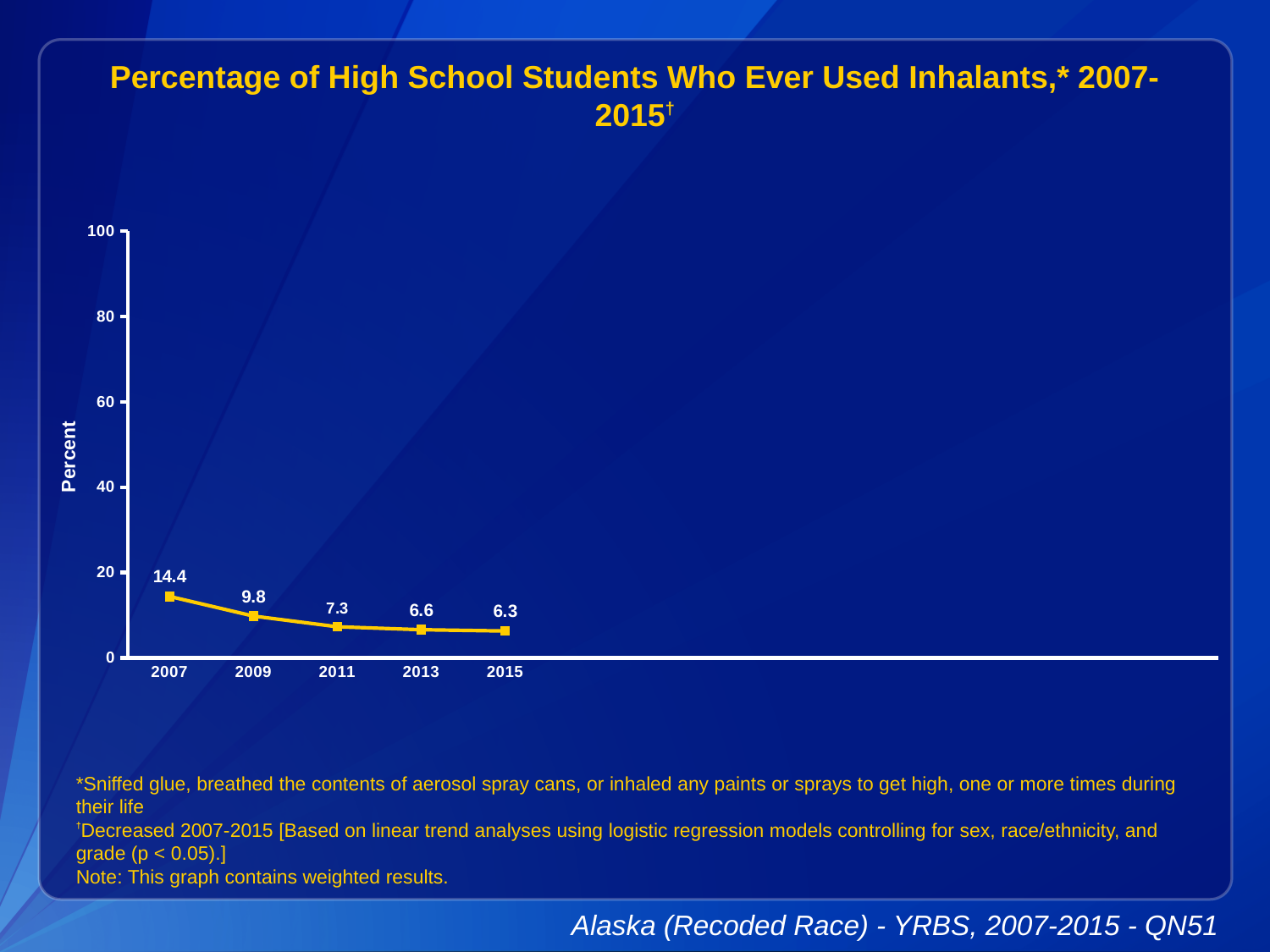
What kind of chart is shown on the slide? line chart What was the percentage of high school students who ever used inhalants in 2011? 7.3 What is the difference between the 2009 and 2011 values? 2.5 Is the value for 2007 greater or less than 20? less Which year had the lowest percentage of students who ever used inhalants? 2015 What was the percentage of high school students who ever used inhalants in 2007? 14.4 Do the values rise or fall from 2007 to 2015? fall Which year had a higher value, 2009 or 2013? 2009 How many years are plotted on the chart? 5 What is the difference between the 2007 and 2015 values? 8.1 Which year had the highest percentage of students who ever used inhalants? 2007 What was the percentage of high school students who ever used inhalants in 2015? 6.3